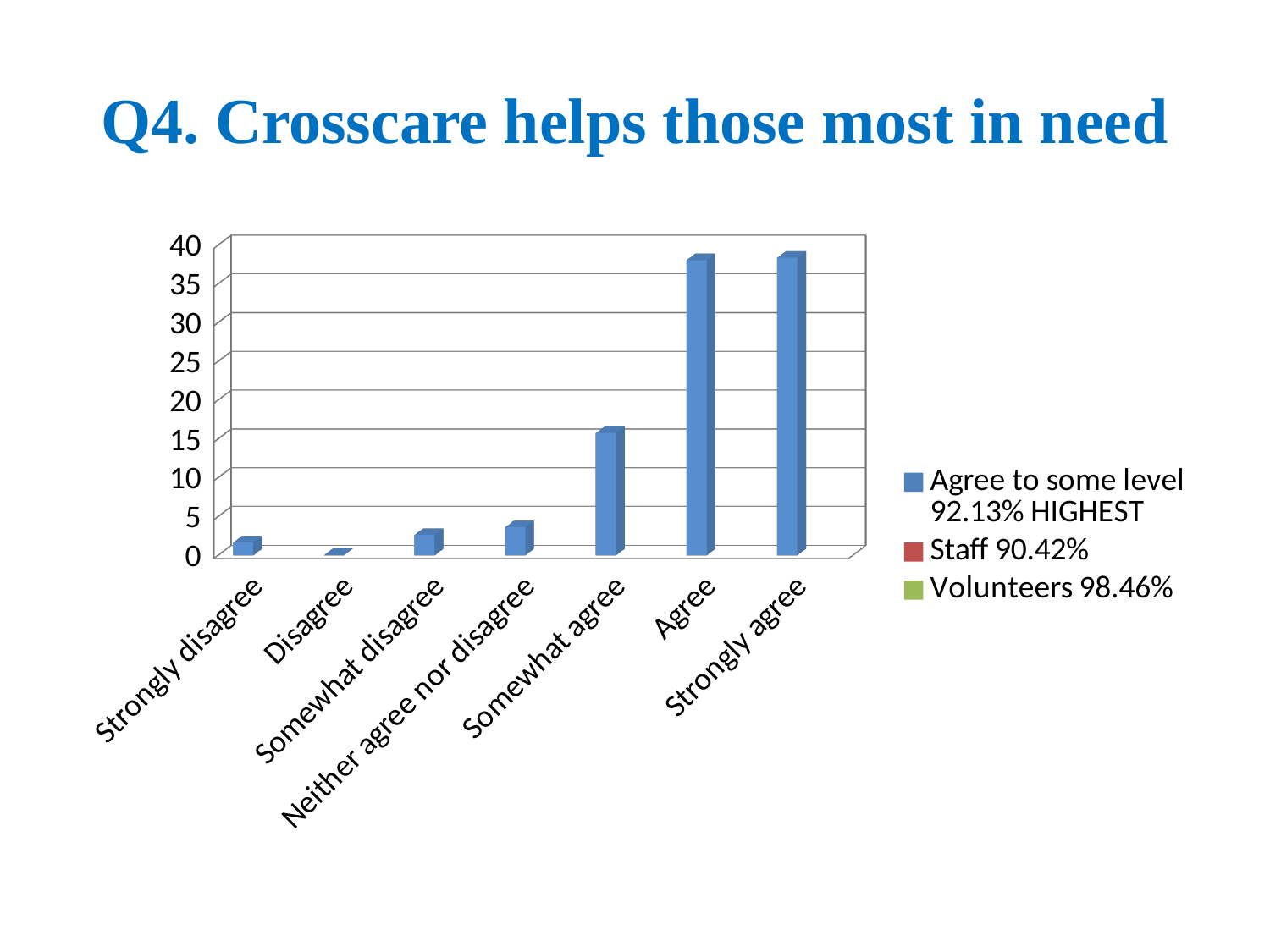
What is the title of the slide containing the chart? Q4. Crosscare helps those most in need Is the value for Agree greater or less than 30? greater How many series does the chart's legend list? 3 Is the value for Somewhat agree greater or less than 10? greater Is the value for Strongly agree greater or less than 35? greater Which is larger, the value for Somewhat agree or the value for Neither agree nor disagree? Somewhat agree What is the first entry listed in the chart's legend? Agree to some level 92.13% HIGHEST How many categories are shown on the x axis of the chart? 7 What kind of chart is shown on the slide? bar chart Which category has the lowest value in the chart? Disagree